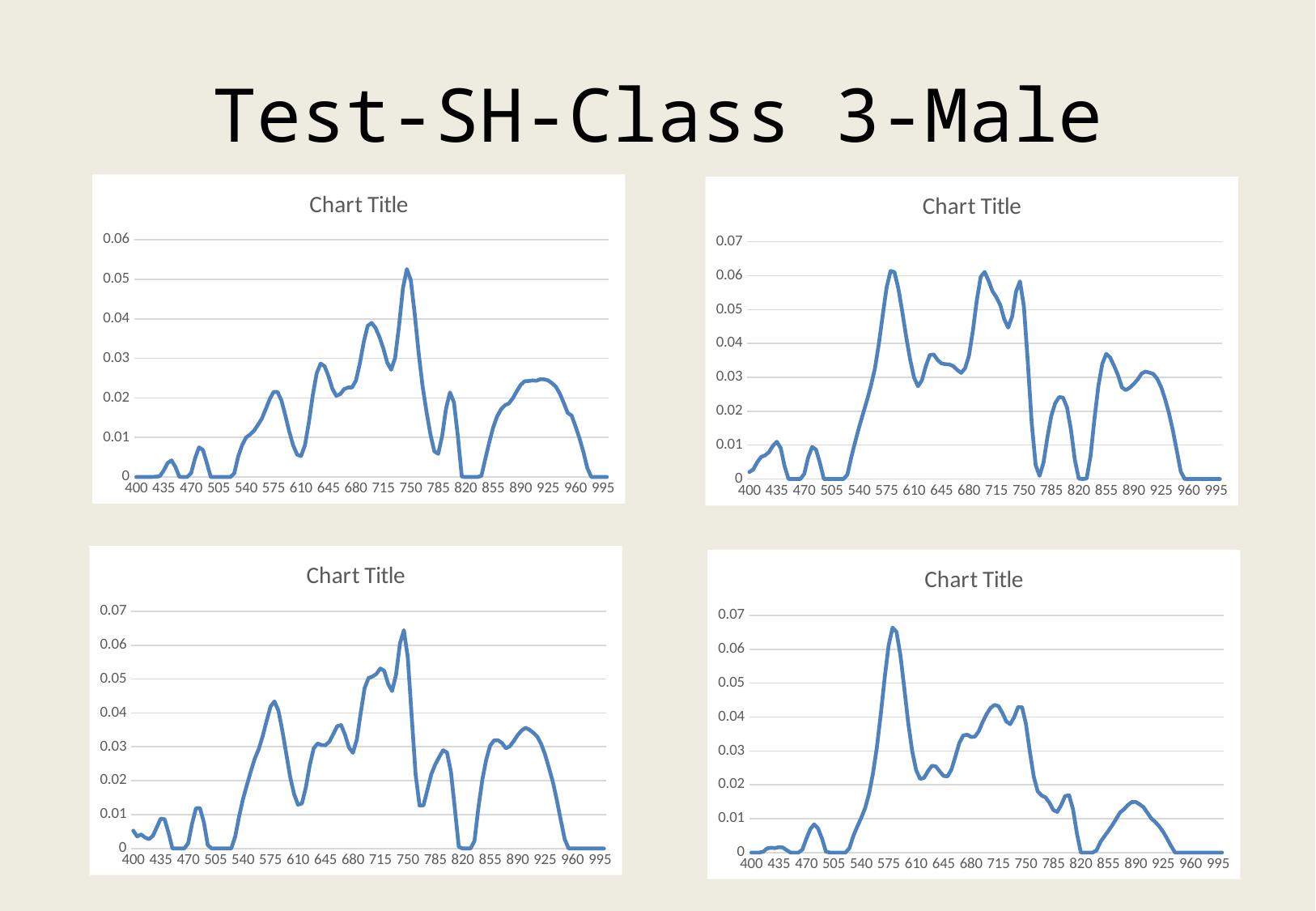
On the top-left chart, which is larger, the value at 575 or the value at 750? 750 What kind of chart is the top-left chart? line chart On the bottom-right chart, do the values rise or fall from 400 to 575? rise On the top-left chart, is the value at 750 greater or less than 0.04? greater On the top-left chart, what is the highest value labelled on the vertical axis? 0.06 On the top-right chart, is the value at 575 greater or less than 0.05? greater On the bottom-left chart, is the value at 750 greater or less than 0.05? greater How many charts are shown on the slide? 4 On the bottom-left chart, which is larger, the value at 575 or the value at 750? 750 What is the title shown on the top-right chart? Chart Title